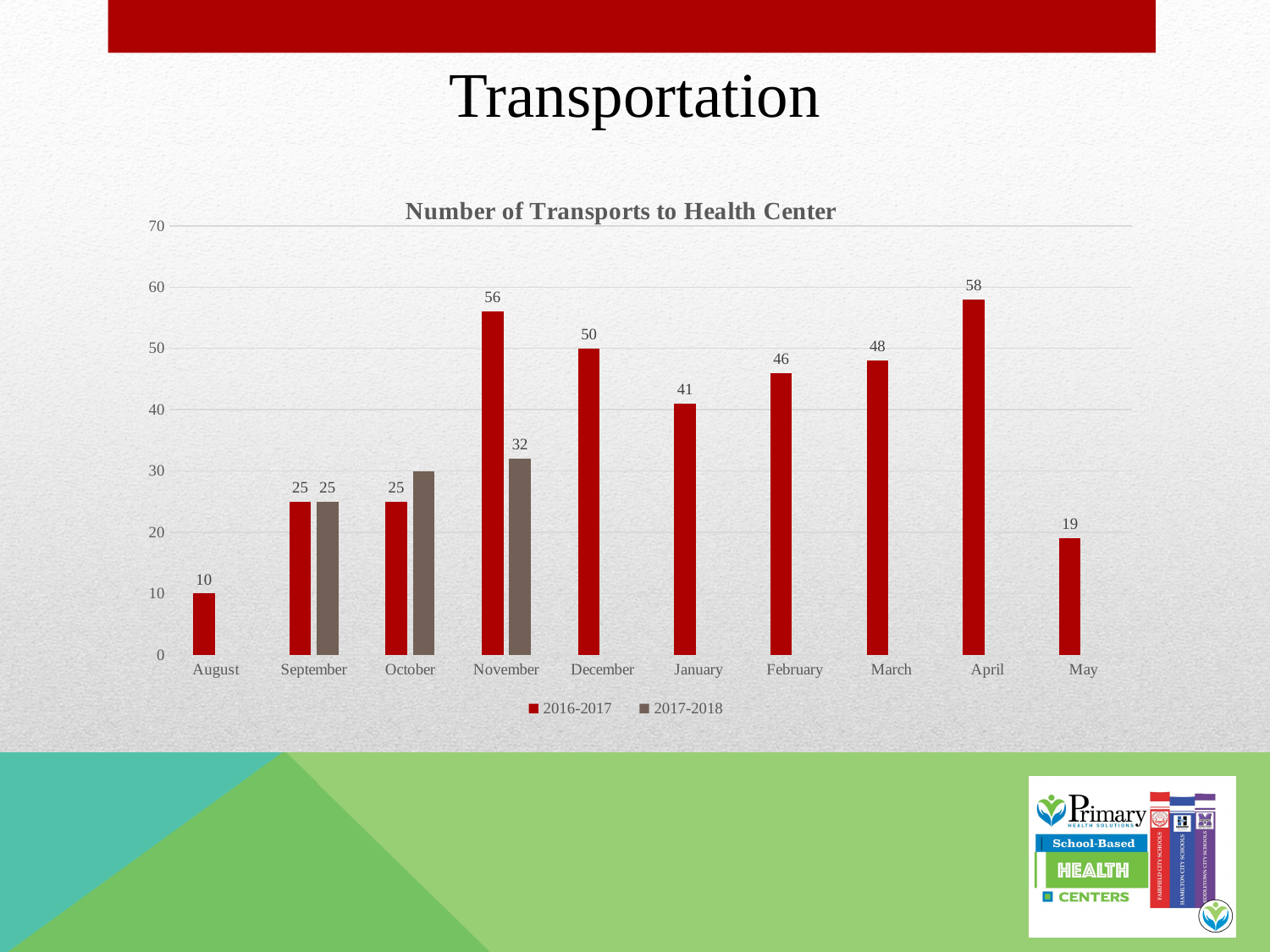
What is the difference between the 2016-2017 and 2017-2018 values for November? 24 What kind of chart is shown on the slide? bar chart What is the value for November in the 2017-2018 series? 32 How many series does the legend list? 2 Which month has the highest value in the 2016-2017 series? April Which month has the lowest value in the 2016-2017 series? August In the 2016-2017 series, which is larger: December or January? December What is the value for April in the 2016-2017 series? 58 How many months are shown on the x axis? 10 What is the title of the chart? Number of Transports to Health Center Is the value for October in the 2017-2018 series greater or less than 20? greater What is the value for August in the 2016-2017 series? 10